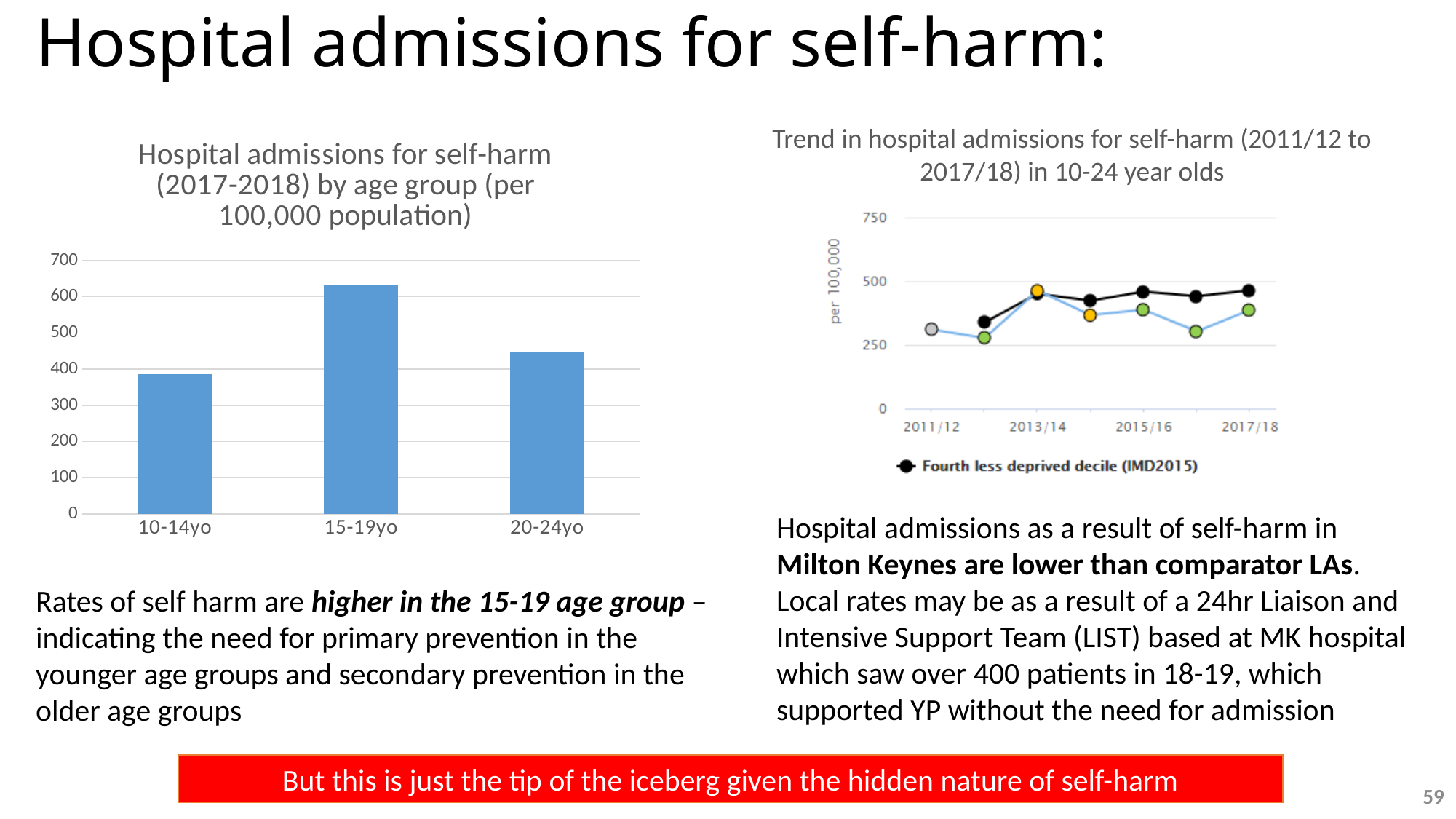
In the right chart, what series name is shown in the legend? Fourth less deprived decile (IMD2015) In the left chart, is the value for 20-24yo greater or less than 500? less In the left chart, which age group has the lowest rate of hospital admissions for self-harm? 10-14yo In the left chart, how many age groups are shown on the x axis? 3 In the right chart, is the value of the black line (Fourth less deprived decile) for 2017/18 greater or less than 500? less In the left chart, what is the highest value shown on the vertical axis? 700 In the left chart, which has the larger value: 20-24yo or 10-14yo? 20-24yo In the left chart, is the value for 15-19yo greater or less than 600? greater In the left chart, which age group has the highest rate of hospital admissions for self-harm? 15-19yo In the left chart, 'Hospital admissions for self-harm (2017-2018) by age group', what kind of chart is used? Bar chart In the right chart, 'Trend in hospital admissions for self-harm (2011/12 to 2017/18) in 10-24 year olds', what kind of chart is used? Line chart